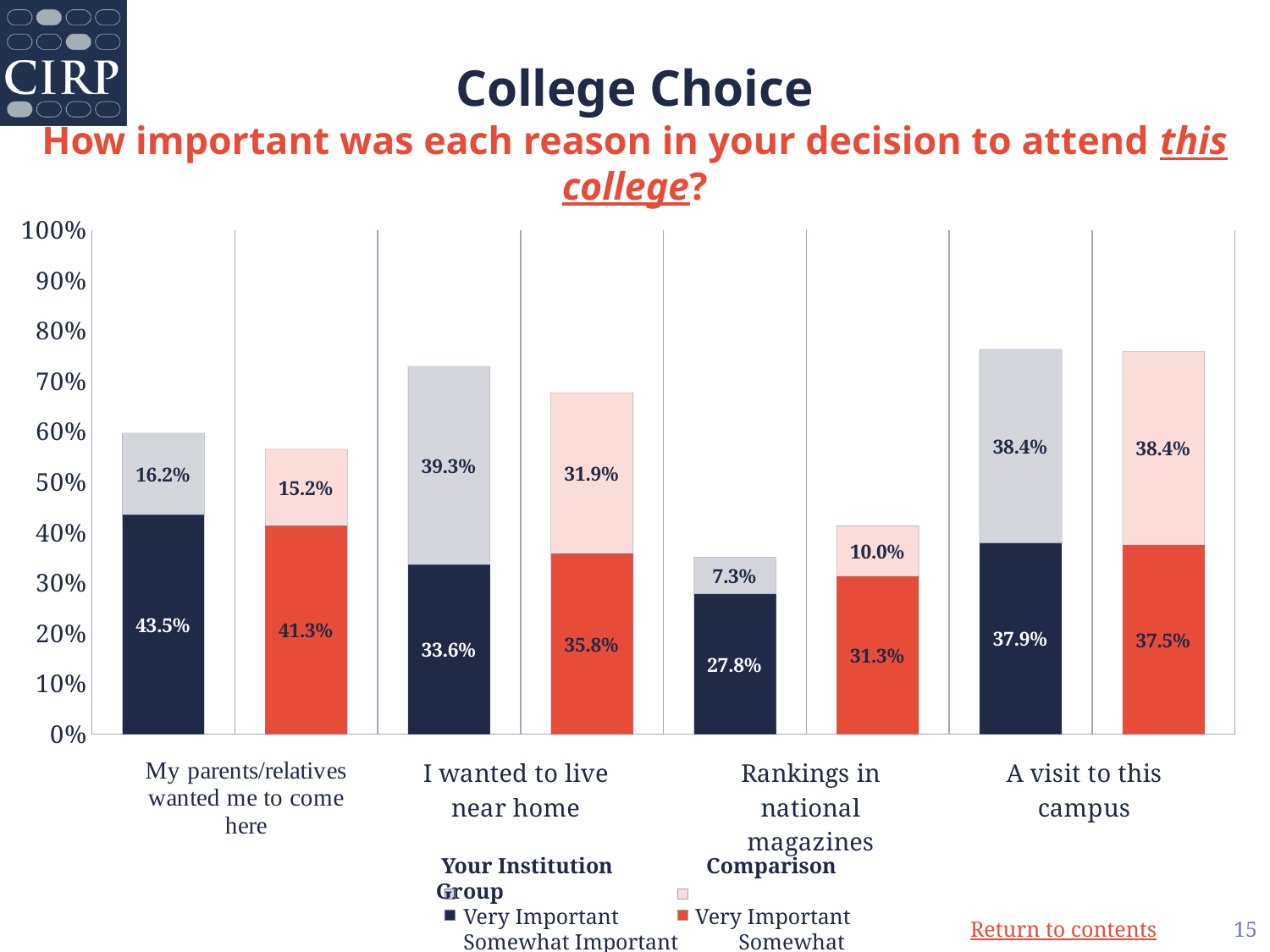
What percentage of students at Your Institution rated "My parents/relatives wanted me to come here" as Very Important? 43.5% How many series does the legend list? 4 Which is larger: the Very Important percentage for "I wanted to live near home" at Your Institution or in the Comparison Group? Comparison Group Which reason has the highest Very Important percentage for the Comparison Group? My parents/relatives wanted me to come here How many reasons (categories) are shown on the x axis? 4 What is the difference between the Very Important percentages for Your Institution and the Comparison Group for "Rankings in national magazines"? 3.5% What kind of chart is shown on the slide? Stacked bar chart Is the total stacked bar for Your Institution for "Rankings in national magazines" greater or less than 40%? less What is the combined Very Important and Somewhat Important percentage for Your Institution for "A visit to this campus"? 76.3% What percentage of students at Your Institution rated "I wanted to live near home" as Somewhat Important? 39.3% Which reason has the lowest Very Important percentage for Your Institution? Rankings in national magazines What percentage of the Comparison Group rated "Rankings in national magazines" as Somewhat Important? 10.0%